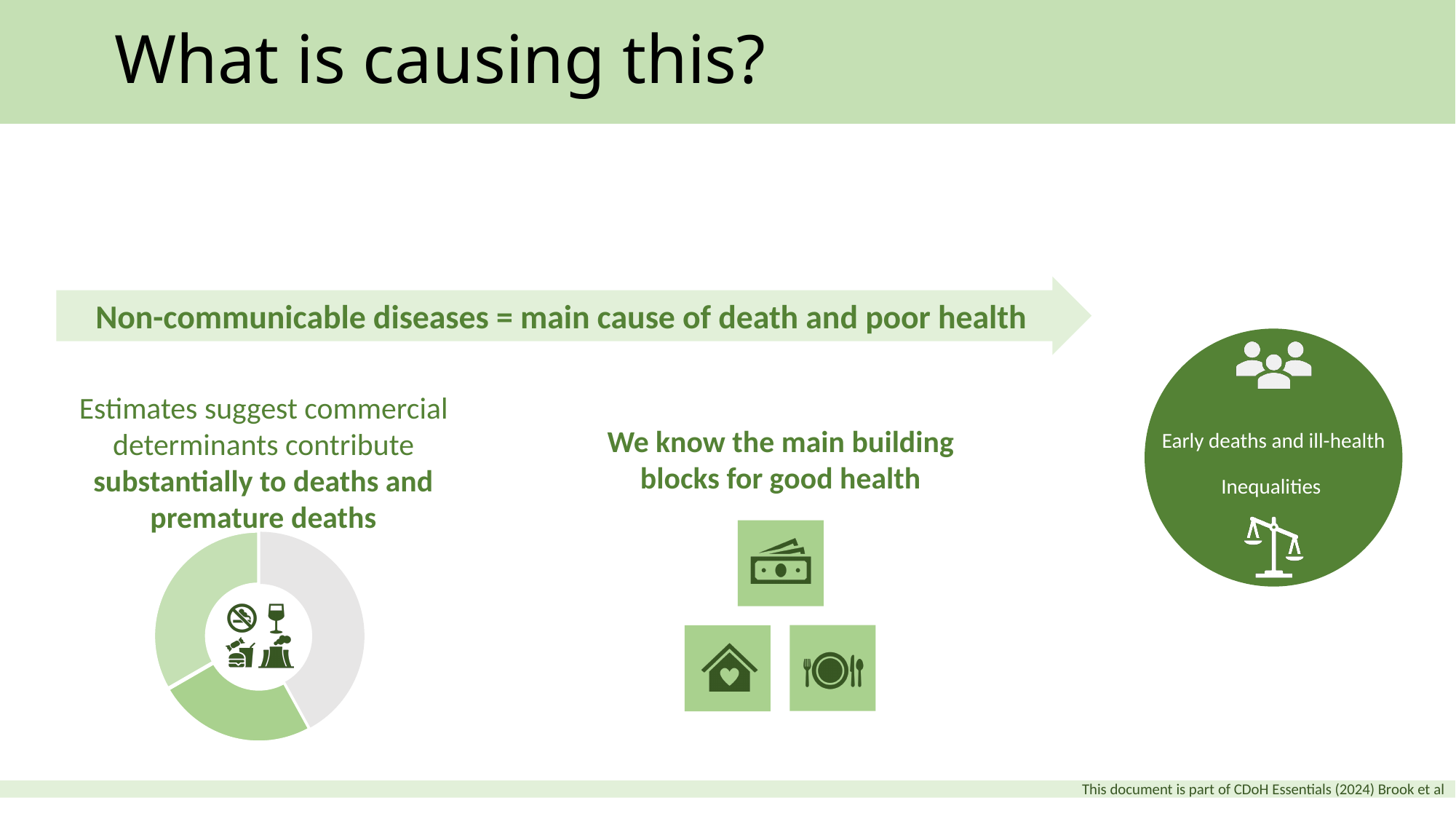
How many slices does the doughnut chart on the left of the slide have? 3 Does the doughnut chart on the left of the slide show a legend? No What kind of chart is shown on the left of the slide, below the text about commercial determinants? doughnut (pie) chart In the doughnut chart on the left, is the grey slice larger or smaller than the medium green slice? larger Which slice of the doughnut chart on the left is smallest: the light green, the medium green, or the grey slice? the medium green slice